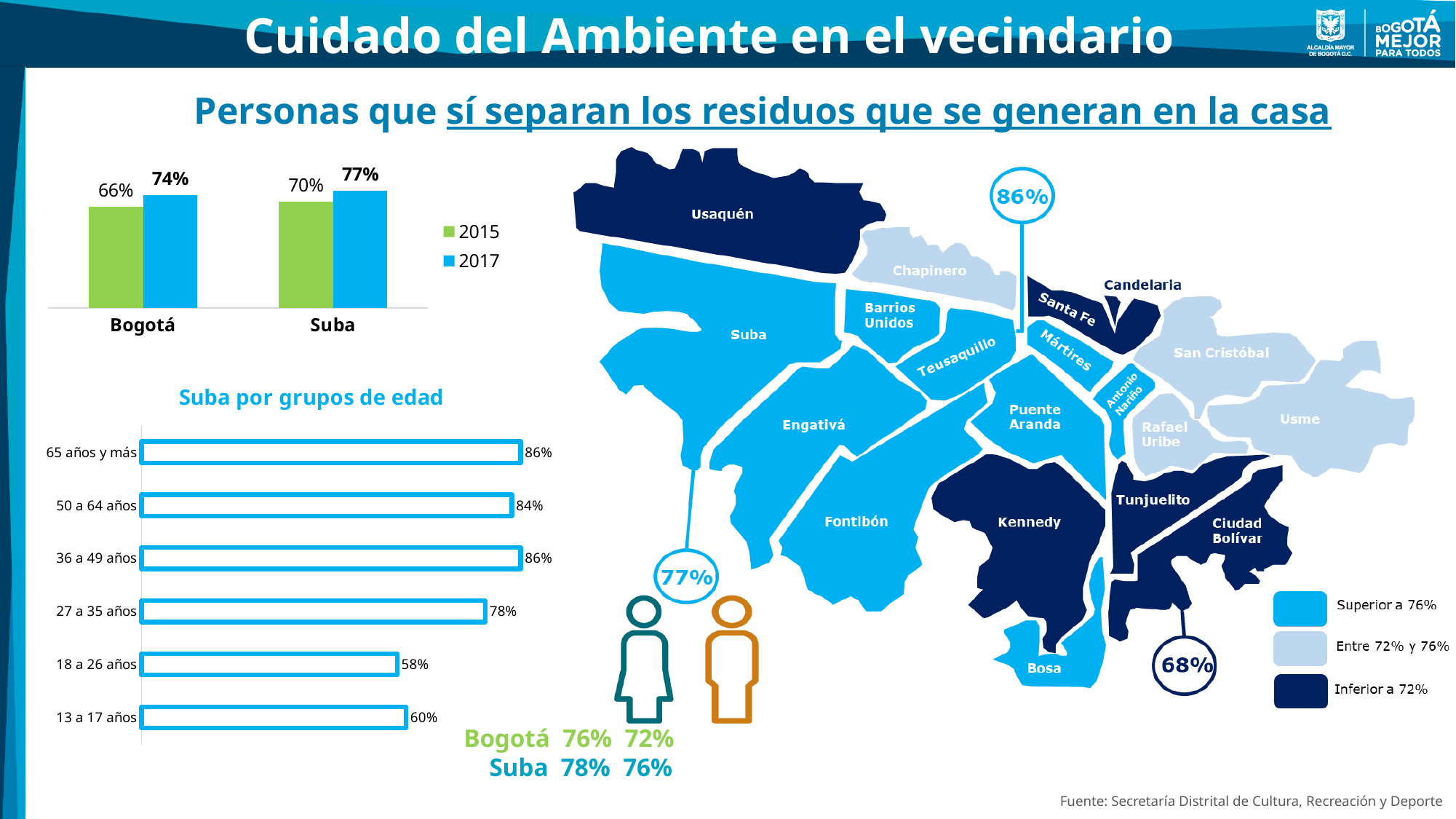
In the 'Suba por grupos de edad' chart, which is larger: 13 a 17 años or 18 a 26 años? 13 a 17 años In the 'Suba por grupos de edad' chart, what is the difference between 50 a 64 años and 27 a 35 años? 6% In the top-left bar chart, what is the value for Bogotá in 2017? 74% What kind of chart is 'Suba por grupos de edad'? Bar chart How many series does the legend of the top-left bar chart list? 2 In the top-left bar chart, what is the value for Suba in 2015? 70% In the 'Suba por grupos de edad' chart, how many age groups are shown? 6 In the 'Suba por grupos de edad' chart, what is the value for 18 a 26 años? 58% In the top-left bar chart, which colour represents 2015? Green In the top-left bar chart, what is the difference between Suba's 2017 and 2015 values? 7% In the 'Suba por grupos de edad' chart, which age group has the lowest value? 18 a 26 años In the top-left bar chart, which is larger: Bogotá 2017 or Suba 2017? Suba 2017